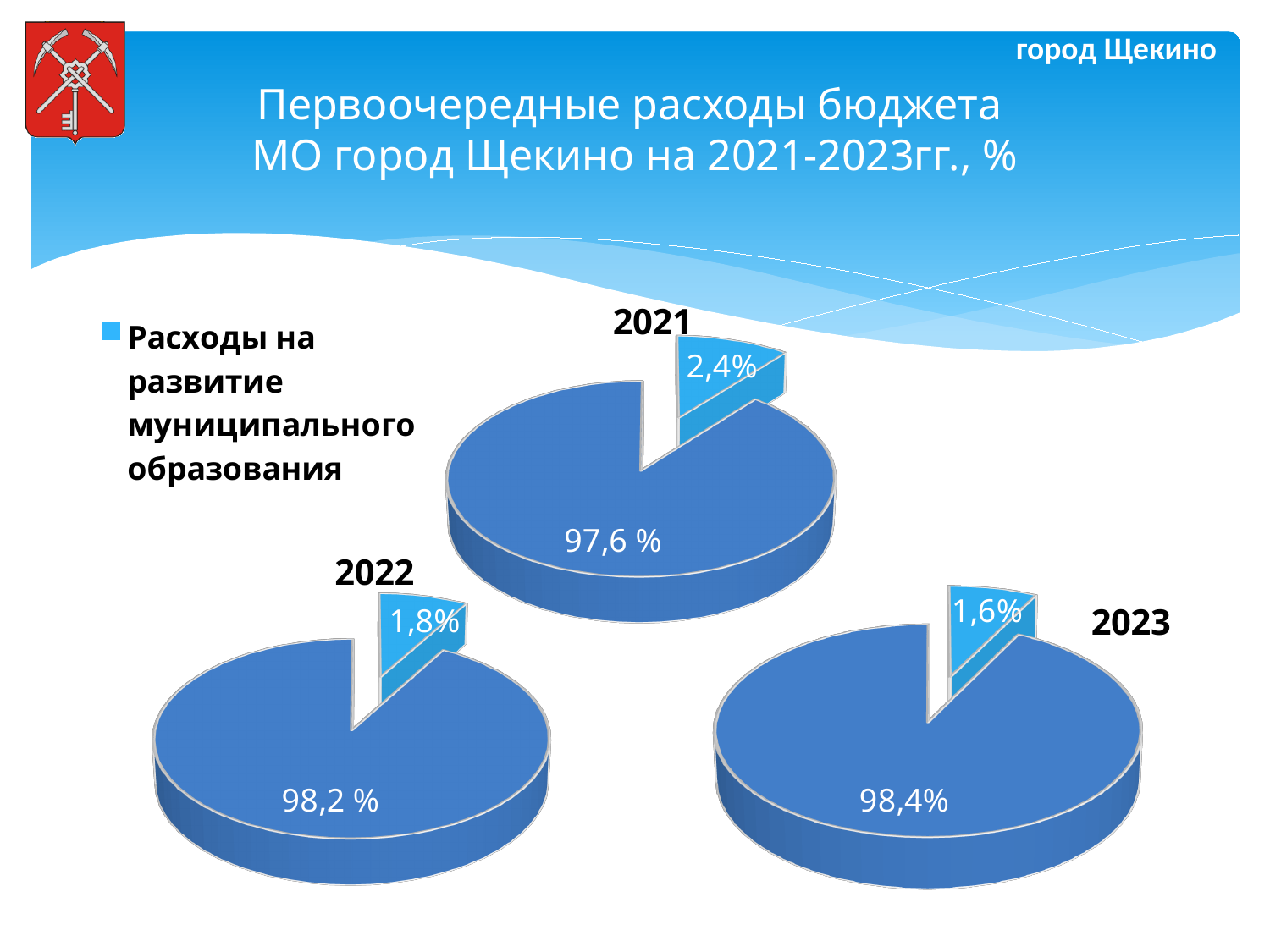
In the 2021 pie chart, what value is shown for the small light blue slice? 2,4% What kind of charts are shown on the slide? Pie charts How many pie charts are shown on the slide? 3 In the 2023 pie chart, what value is shown for the large dark blue slice? 98,4% In the 2022 pie chart, what value is shown for the small light blue slice? 1,8% What is the difference between the light blue slice values in the 2021 and 2023 pie charts? 0,8% Does the light blue slice value rise or fall from 2021 to 2023 across the pie charts? Fall Which year's pie chart shows the largest light blue slice (Расходы на развитие муниципального образования)? 2021 Which year's pie chart shows the smallest light blue slice (Расходы на развитие муниципального образования)? 2023 In the 2022 pie chart, what value is shown for the large dark blue slice? 98,2 % In the 2021 pie chart, what value is shown for the large dark blue slice? 97,6 % Is the light blue slice value larger in the 2022 pie chart or in the 2023 pie chart? 2022